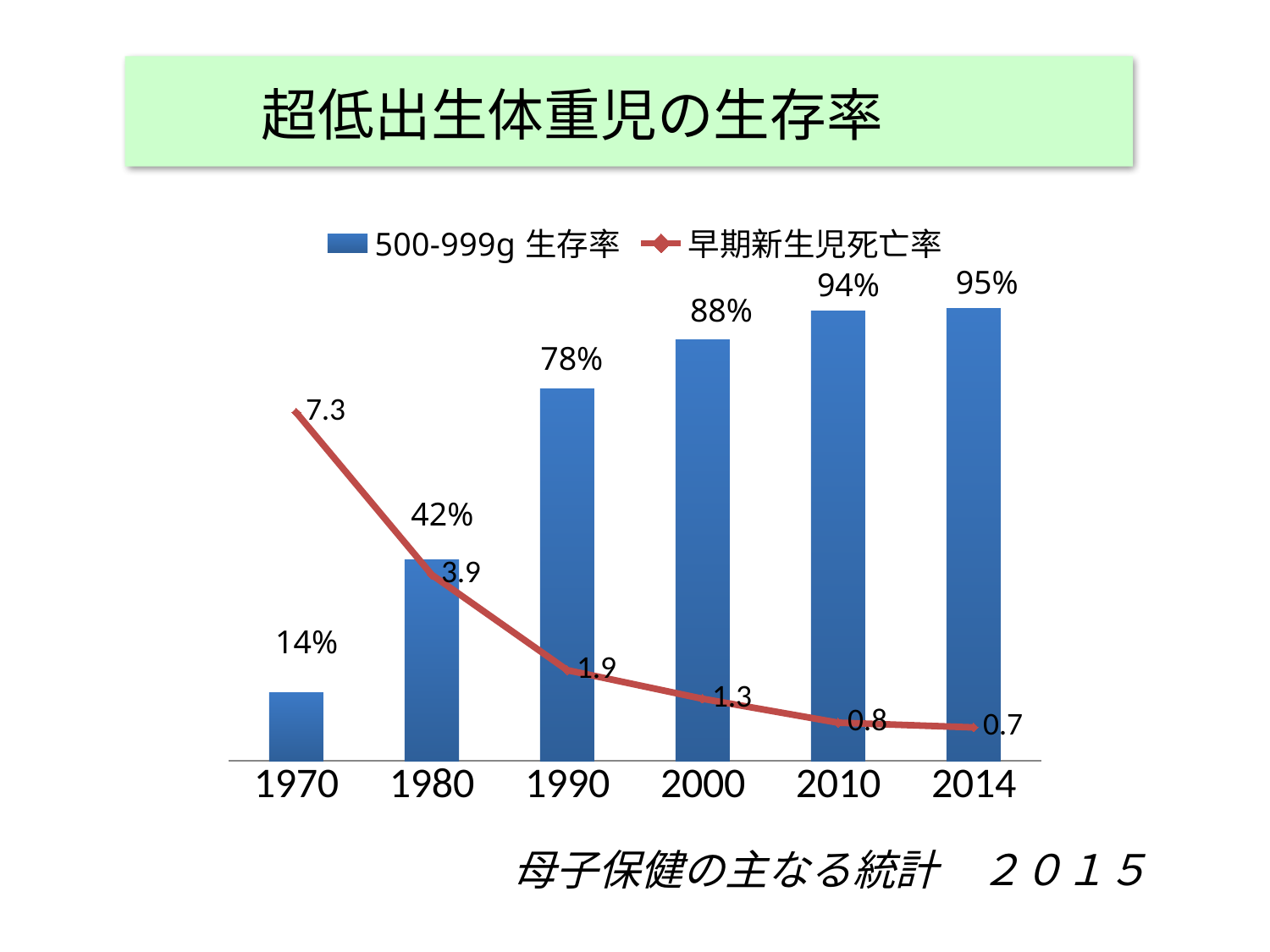
What is the difference in 500-999g 生存率 between 1980 and 1970? 28% Which is larger, the 500-999g 生存率 for 2000 or for 1990? 2000 Which year has the highest 500-999g 生存率? 2014 Which year has the lowest 早期新生児死亡率? 2014 What is the 500-999g 生存率 value for 1990? 78% How many years are shown on the x axis? 6 What is the difference in 早期新生児死亡率 between 1970 and 1980? 3.4 What kind of chart is used for the 500-999g 生存率 series? bar chart Does the 早期新生児死亡率 rise or fall from 1970 to 2014? fall What is the 早期新生児死亡率 value for 2000? 1.3 What is the 早期新生児死亡率 value for 1970? 7.3 How many series does the legend list? 2